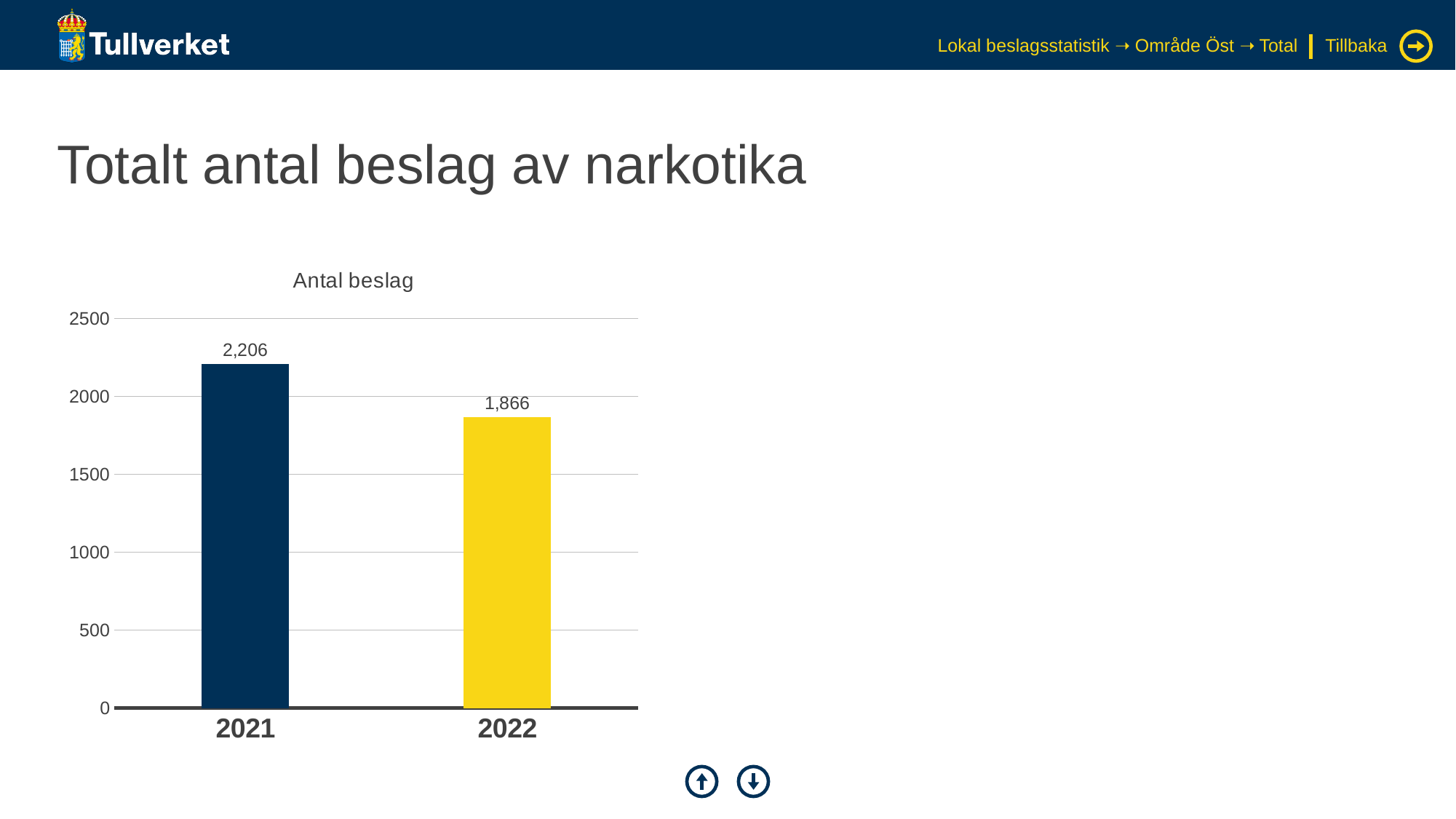
What is the value for 2022? 1,866 What is the value for 2021? 2,206 Which year has the highest number of seizures? 2021 What kind of chart is shown? bar chart Which is larger, the value for 2021 or the value for 2022? 2021 How many categories are shown on the x axis? 2 What is the title of the chart? Antal beslag Is the value for 2022 greater or less than 2000? less Do the values rise or fall from 2021 to 2022? fall Which year has the lowest number of seizures? 2022 Is the value for 2021 greater or less than 2000? greater What is the difference between the values for 2021 and 2022? 340